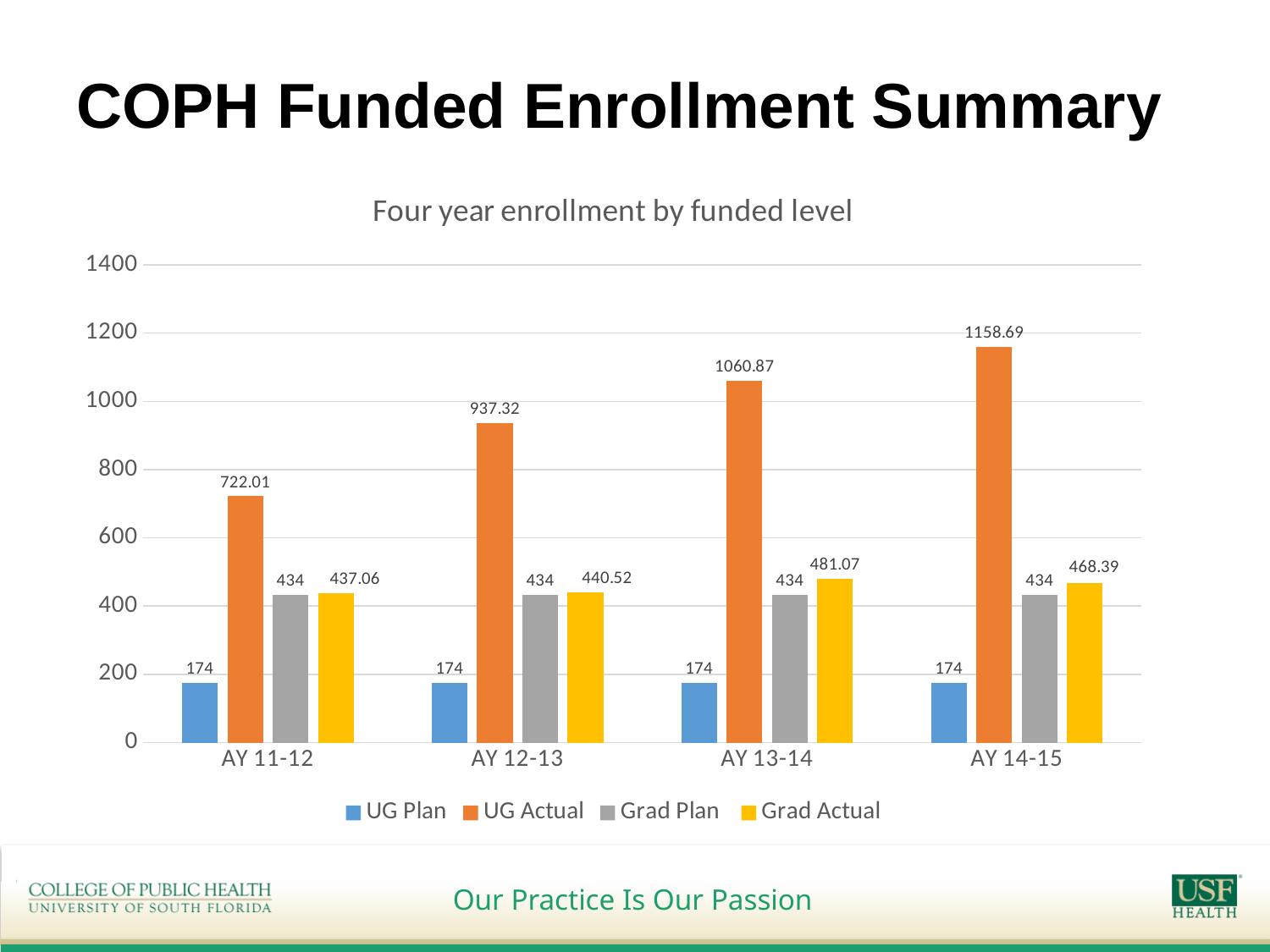
Which academic year has the lowest Grad Actual value? AY 11-12 Does the UG Actual value rise or fall from AY 11-12 to AY 14-15? rise What kind of chart is shown on the slide? bar chart Which is larger for AY 13-14: Grad Actual or Grad Plan? Grad Actual What is the UG Actual value for AY 12-13? 937.32 Is the UG Actual value for AY 11-12 greater or less than 800? less What is the difference between UG Actual and UG Plan for AY 14-15? 984.69 Which academic year has the highest UG Actual value? AY 14-15 What is the UG Plan value for AY 11-12? 174 How many academic years are shown on the x axis? 4 How many series does the legend list? 4 What is the Grad Actual value for AY 13-14? 481.07